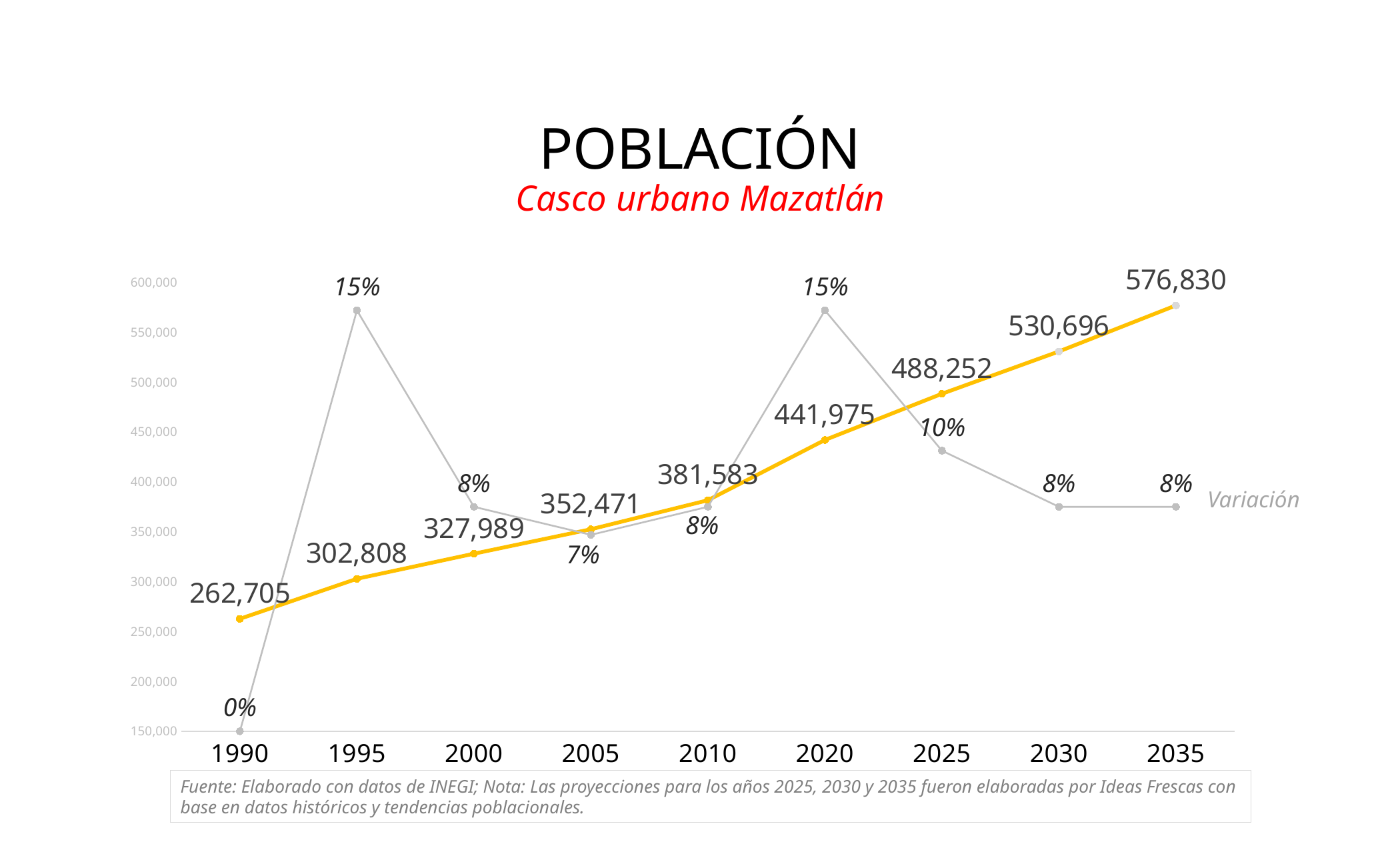
How many years are shown on the x axis? 9 Which is larger, the population value for 2010 or for 2005? 2010 What is the Variación percentage shown for 2025? 10% What is the population value shown for 2020? 441,975 What kind of chart is shown on the slide? Line chart Which year has the highest population value? 2035 What is the population value shown for 1990? 262,705 What is the difference between the population values for 2035 and 1990? 314,125 Does the population line rise or fall from 1990 to 2035? Rises What is the Variación percentage shown for 1995? 15% What is the population value shown for 2035? 576,830 Which year has the lowest population value? 1990